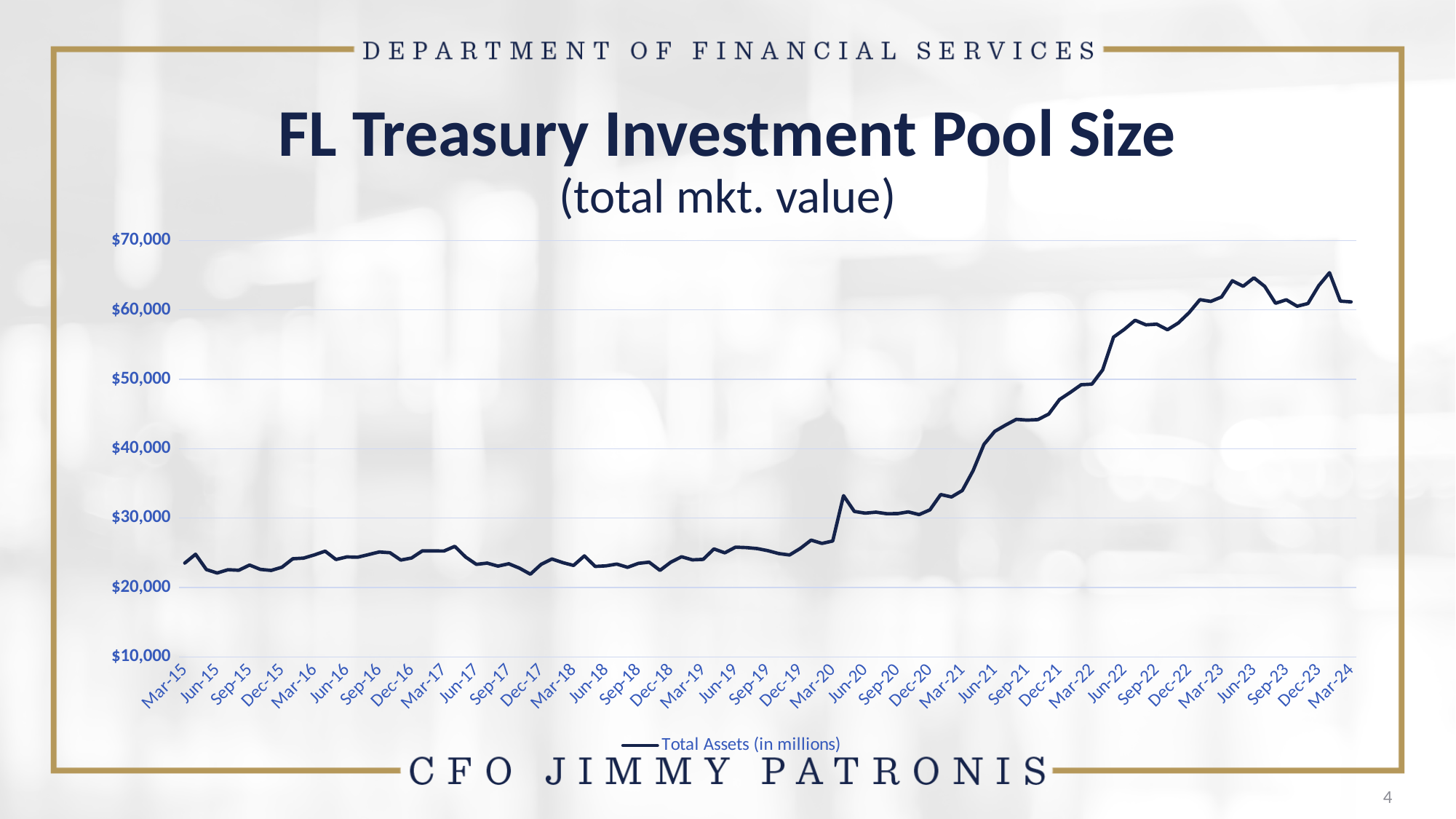
How many series does the legend list? 1 Is the value for Jun-22 greater or less than $50,000? greater Is the value for Mar-15 greater or less than $30,000? less What kind of chart is shown on the slide? Line chart What is the name of the series shown in the legend? Total Assets (in millions) Overall, do the values rise or fall from Mar-15 to Mar-24? Rise What is the title of the chart? FL Treasury Investment Pool Size (total mkt. value) Is the value for Mar-24 greater or less than $50,000? greater Which is larger, the value for Mar-24 or the value for Mar-15? Mar-24 How many date labels are shown on the x axis? 37